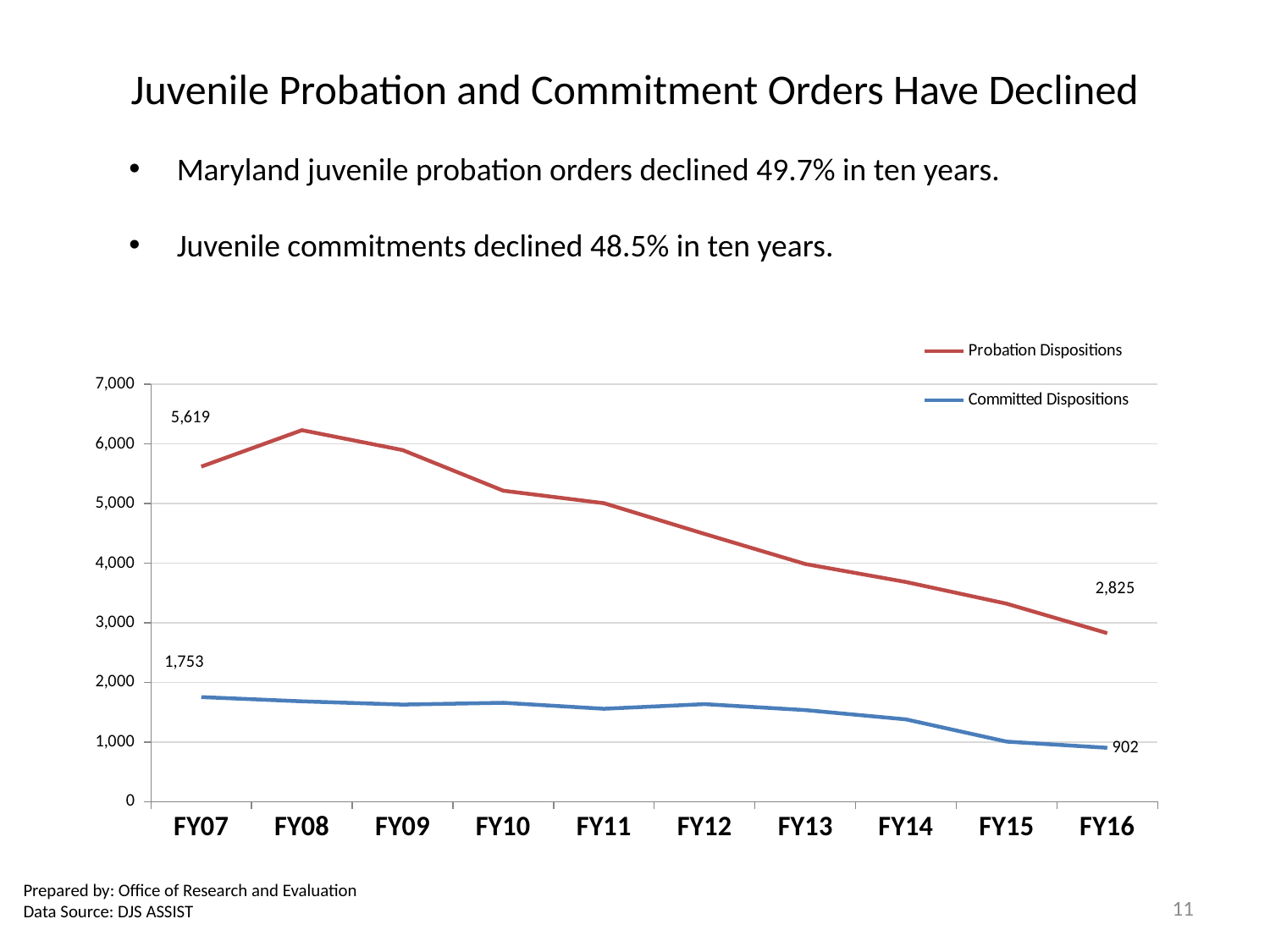
What kind of chart is shown on the slide? line chart By how much did Probation Dispositions decrease from FY07 to FY16? 2,794 Is the value for Probation Dispositions in FY08 greater or less than 6,000? greater What is the value of Committed Dispositions in FY07? 1,753 By how much did Committed Dispositions decrease from FY07 to FY16? 851 What is the value of Probation Dispositions in FY07? 5,619 How many series does the legend list? 2 What is the value of Committed Dispositions in FY16? 902 Is the value for Probation Dispositions in FY12 greater or less than 5,000? less In FY07, which series has the larger value, Probation Dispositions or Committed Dispositions? Probation Dispositions How many fiscal years are shown on the x axis? 10 What is the value of Probation Dispositions in FY16? 2,825